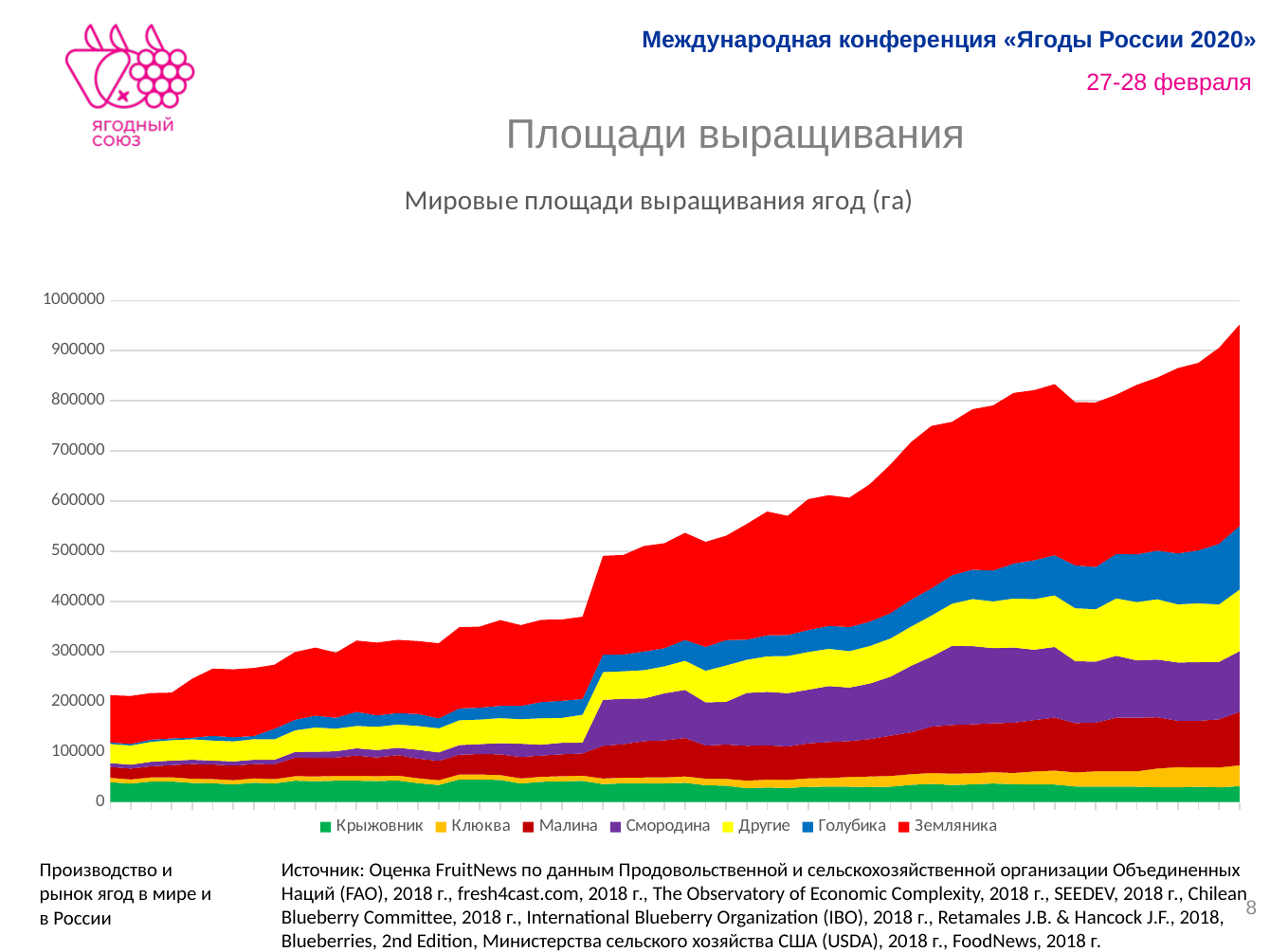
Which colour represents Земляника in the chart? Red Does the total world berry growing area rise or fall along the x axis? Rise Is the total stacked value at the left end of the chart greater or less than 300000? less Is the total stacked value at the right end of the chart greater or less than 1000000? less Is the total stacked value at the right end of the chart greater or less than 900000? greater What kind of chart is shown on the slide? Stacked area chart Which series occupies the largest area at the right end of the chart? Земляника What is the title of the chart? Мировые площади выращивания ягод (га) At the right end of the chart, which series has the larger area: Земляника or Голубика? Земляника What is the highest value shown on the y axis of the chart? 1000000 How many series does the legend of the chart list? 7